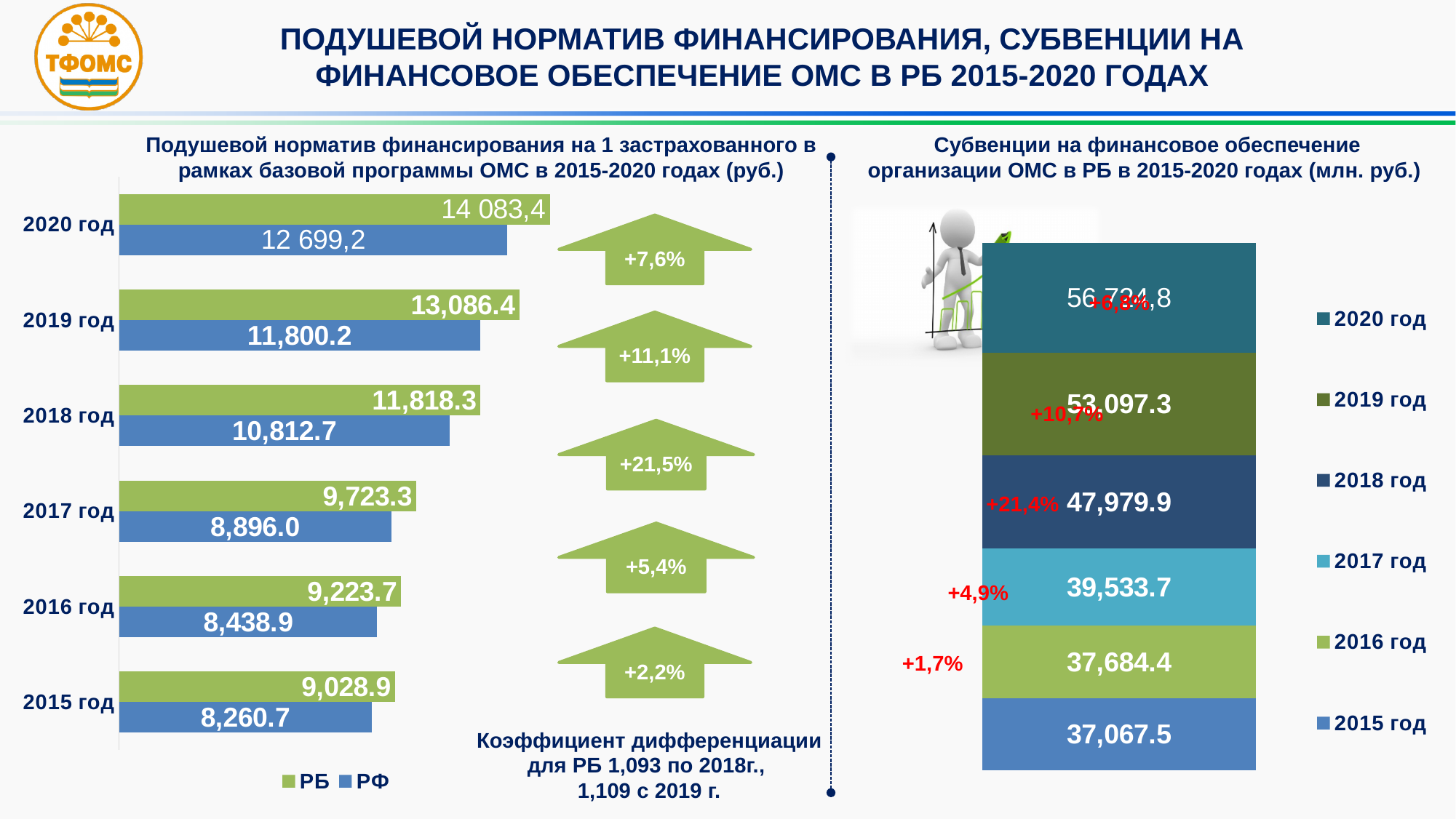
In the left chart (Подушевой норматив финансирования), which year has the highest РБ value? 2020 год In the left chart (Подушевой норматив финансирования), which year has the lowest РФ value? 2015 год In the left chart (Подушевой норматив финансирования), which is larger: the РБ value for 2016 год or the РБ value for 2015 год? 2016 год In the right chart (Субвенции на финансовое обеспечение), what is the value for 2018 год? 47,979.9 In the left chart (Подушевой норматив финансирования), what is the value for РБ in 2019 год? 13,086.4 Do the РБ values in the left chart (Подушевой норматив финансирования) rise or fall from 2015 год to 2020 год? Rise What kind of chart is the left chart (Подушевой норматив финансирования)? Bar chart How many years are shown in the left chart (Подушевой норматив финансирования)? 6 In the left chart (Подушевой норматив финансирования), what is the value for РФ in 2017 год? 8,896.0 In the right chart (Субвенции на финансовое обеспечение), what is the difference between the values for 2019 год and 2018 год? 5,117.4 In the left chart (Подушевой норматив финансирования), what is the difference between the РБ and РФ values for 2018 год? 1,005.6 How many series does the legend of the left chart (Подушевой норматив финансирования) list? 2